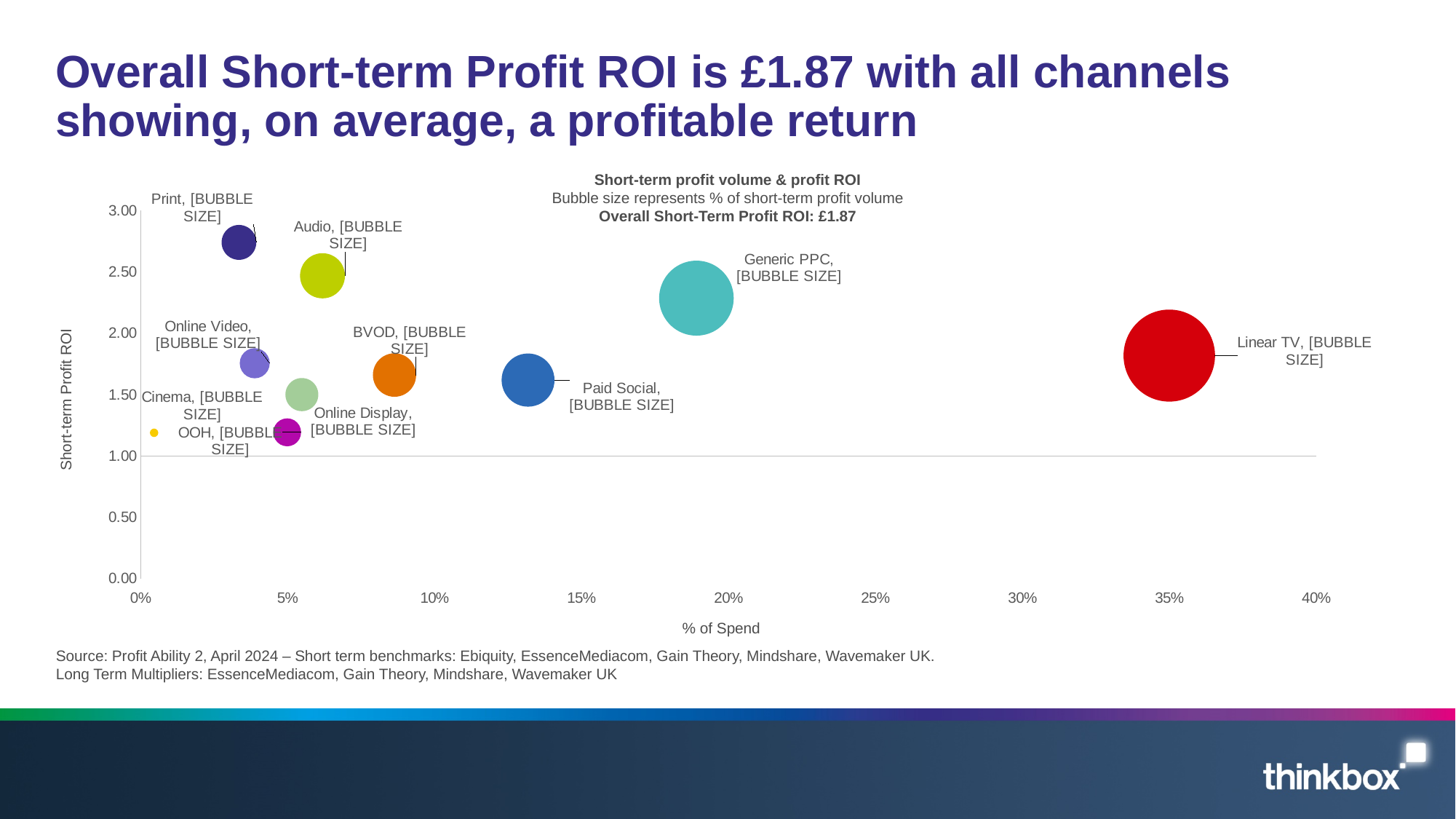
Which channel has the highest Short-term Profit ROI? Print How many channels (bubbles) are plotted on the chart? 10 Is the Short-term Profit ROI for Generic PPC greater or less than 2.00? greater Which channel has the largest bubble (largest share of short-term profit volume)? Linear TV What kind of chart is shown on the slide? Bubble chart Which has the higher % of Spend, Generic PPC or Paid Social? Generic PPC Is the Short-term Profit ROI for Paid Social greater or less than 2.00? less Which has the higher Short-term Profit ROI, Print or Audio? Print According to the chart subtitle, what is the Overall Short-Term Profit ROI? £1.87 Is the Short-term Profit ROI for Print greater or less than 2.50? greater Which channel has the highest % of Spend? Linear TV